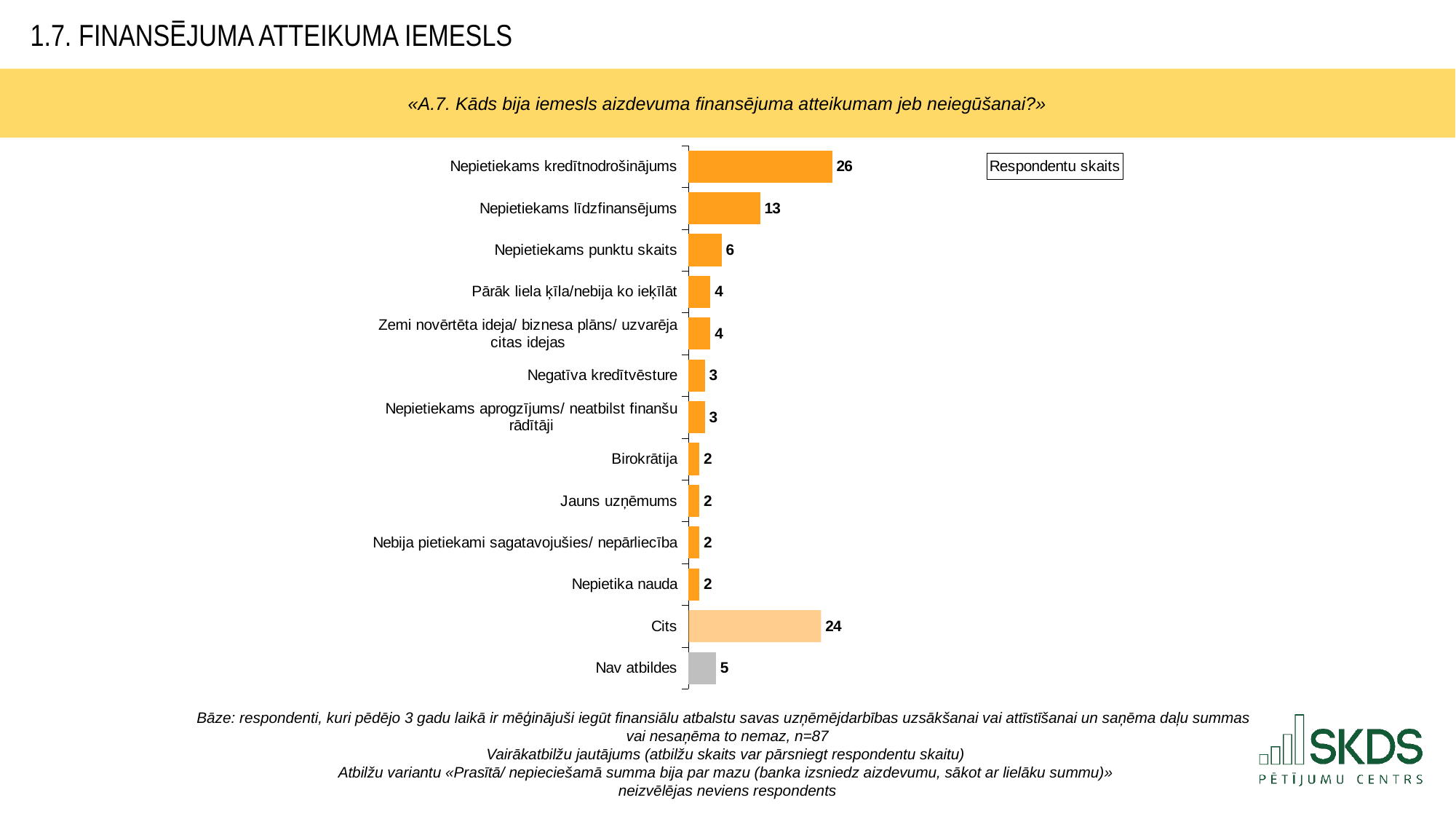
What is the value for "Cits"? 24 How many categories are shown in the chart? 13 What is the value for "Nav atbildes"? 5 What is the difference between the values for "Nepietiekams kredītnodrošinājums" and "Nepietiekams līdzfinansējums"? 13 What does the label in the box at the top right of the chart say? Respondentu skaits Which is larger, the value for "Nepietiekams punktu skaits" or the value for "Birokrātija"? Nepietiekams punktu skaits What is the value for "Nepietiekams līdzfinansējums"? 13 What kind of chart is shown on the slide? Bar chart What is the difference between the values for "Cits" and "Nav atbildes"? 19 What is the value for "Nepietiekams kredītnodrošinājums"? 26 Which category has the highest value? Nepietiekams kredītnodrošinājums What is the value for "Negatīva kredītvēsture"? 3